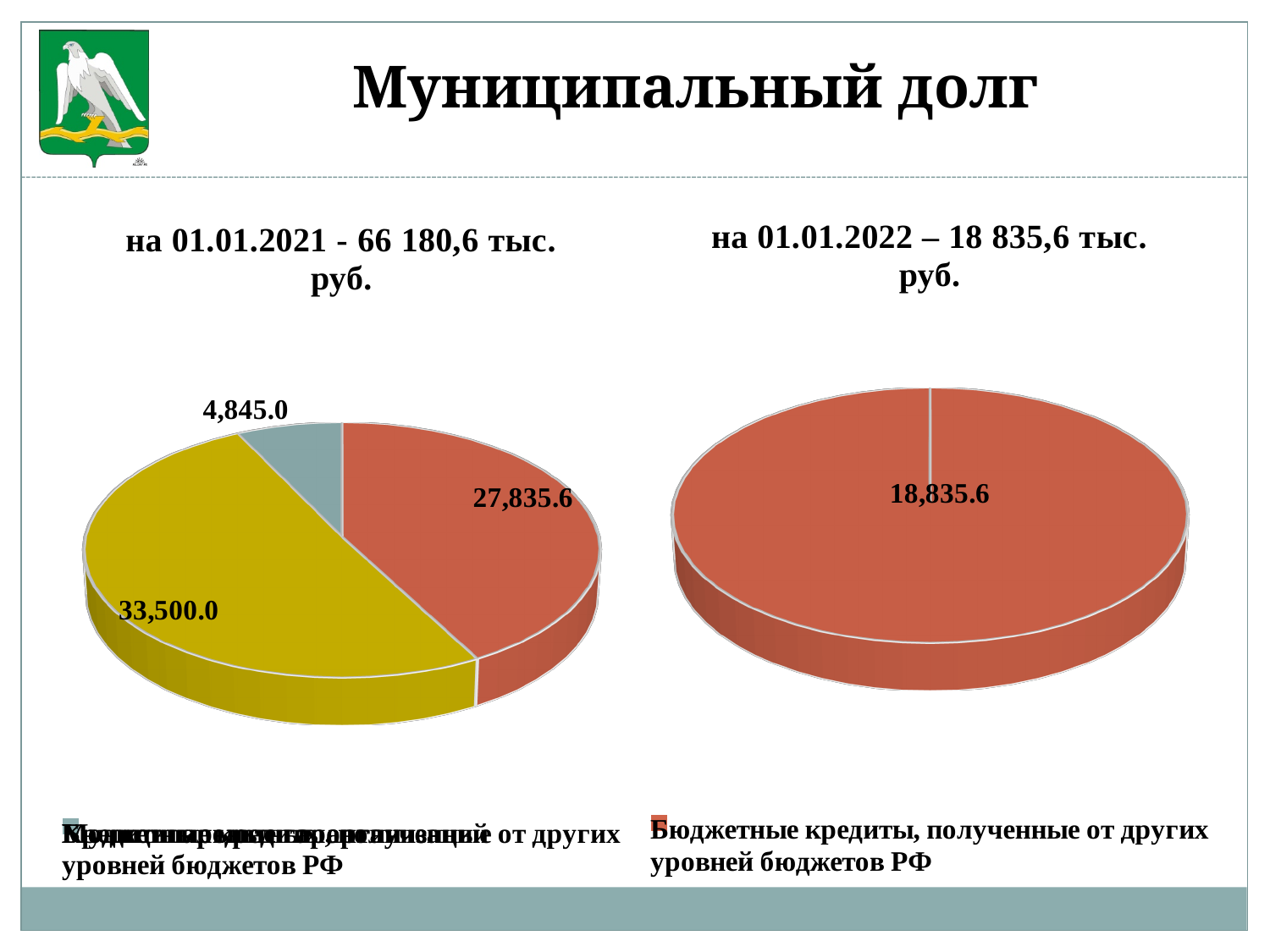
What kind of chart is shown on the left side of the slide (на 01.01.2021)? Pie chart In the left chart (на 01.01.2021), how many slices does the pie have? 3 In the left chart (на 01.01.2021), what is the value of the red slice? 27,835.6 In the left chart (на 01.01.2021), what is the total of the three slices? 66,180.6 What is the legend entry shown under the right chart (на 01.01.2022)? Бюджетные кредиты, полученные от других уровней бюджетов РФ In the left chart (на 01.01.2021), which slice has the smallest value? 4,845.0 (grey-blue slice) In the right chart (на 01.01.2022), how many slices does the pie have? 1 In the right chart (на 01.01.2022), what value is printed on the pie? 18,835.6 In the left chart (на 01.01.2021), which slice has the largest value? 33,500.0 (yellow slice) In the left chart (на 01.01.2021), what is the difference between the yellow slice (33,500.0) and the red slice (27,835.6)? 5,664.4 What kind of chart is shown on the right side of the slide (на 01.01.2022)? Pie chart In the left chart (на 01.01.2021), what is the value of the yellow slice? 33,500.0